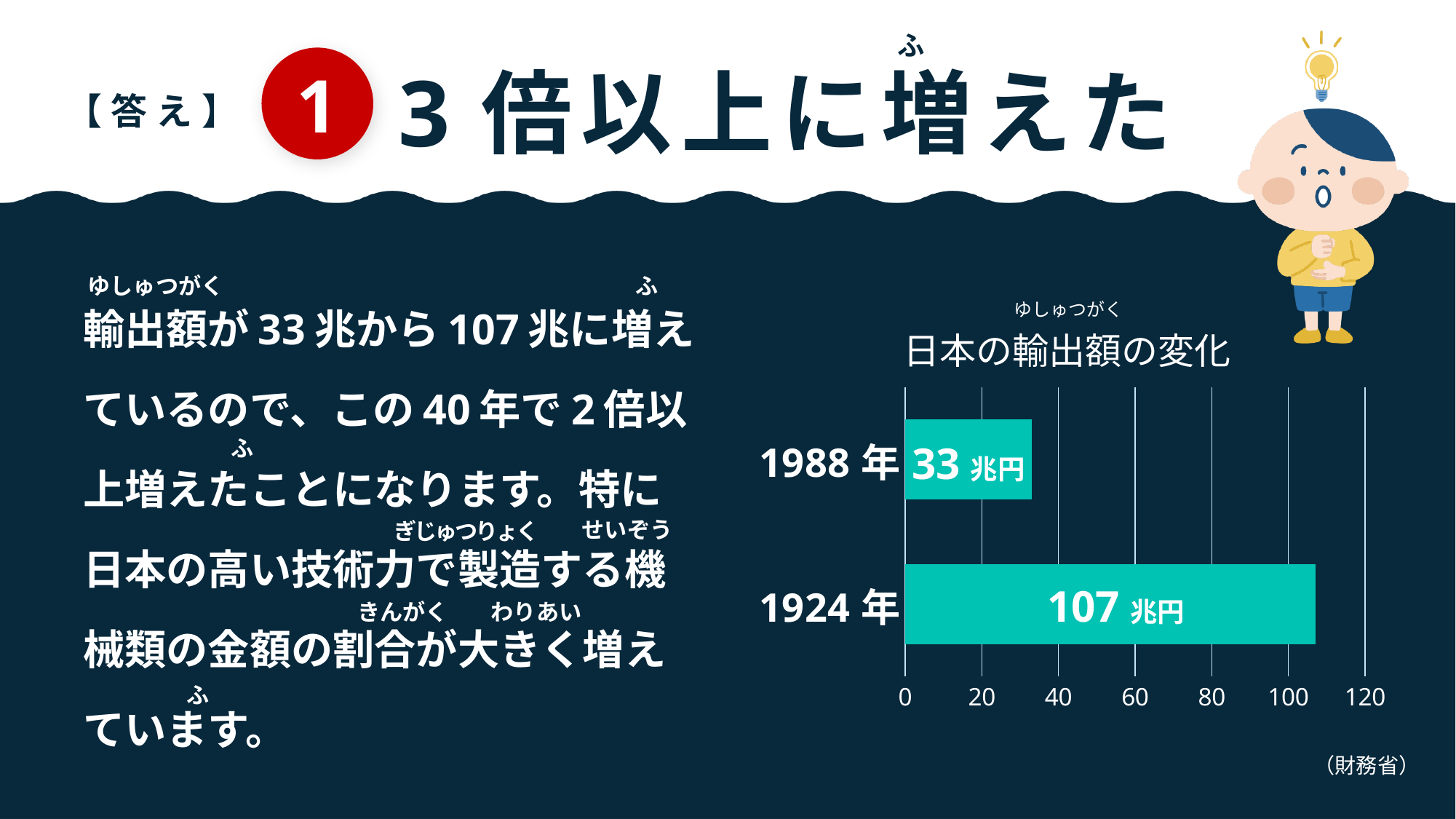
Which category has the highest value in the chart 日本の輸出額の変化? 1924 年 What kind of chart is 日本の輸出額の変化? bar chart In the chart 日本の輸出額の変化, which is larger: the value for 1988 年 or the value for 1924 年? 1924 年 Is the value for 1988 年 in the chart 日本の輸出額の変化 greater or less than 40? less What is the value shown for 1988 年 in the chart 日本の輸出額の変化? 33 兆円 What is the highest tick value shown on the horizontal axis of the chart 日本の輸出額の変化? 120 Which category has the lowest value in the chart 日本の輸出額の変化? 1988 年 What is the title of the chart on the slide? 日本の輸出額の変化 What is the difference between the values for 1924 年 and 1988 年 in the chart 日本の輸出額の変化? 74 兆円 How many categories (bars) are shown in the chart 日本の輸出額の変化? 2 What is the value shown for 1924 年 in the chart 日本の輸出額の変化? 107 兆円 Is the value for 1924 年 in the chart 日本の輸出額の変化 greater or less than 100? greater